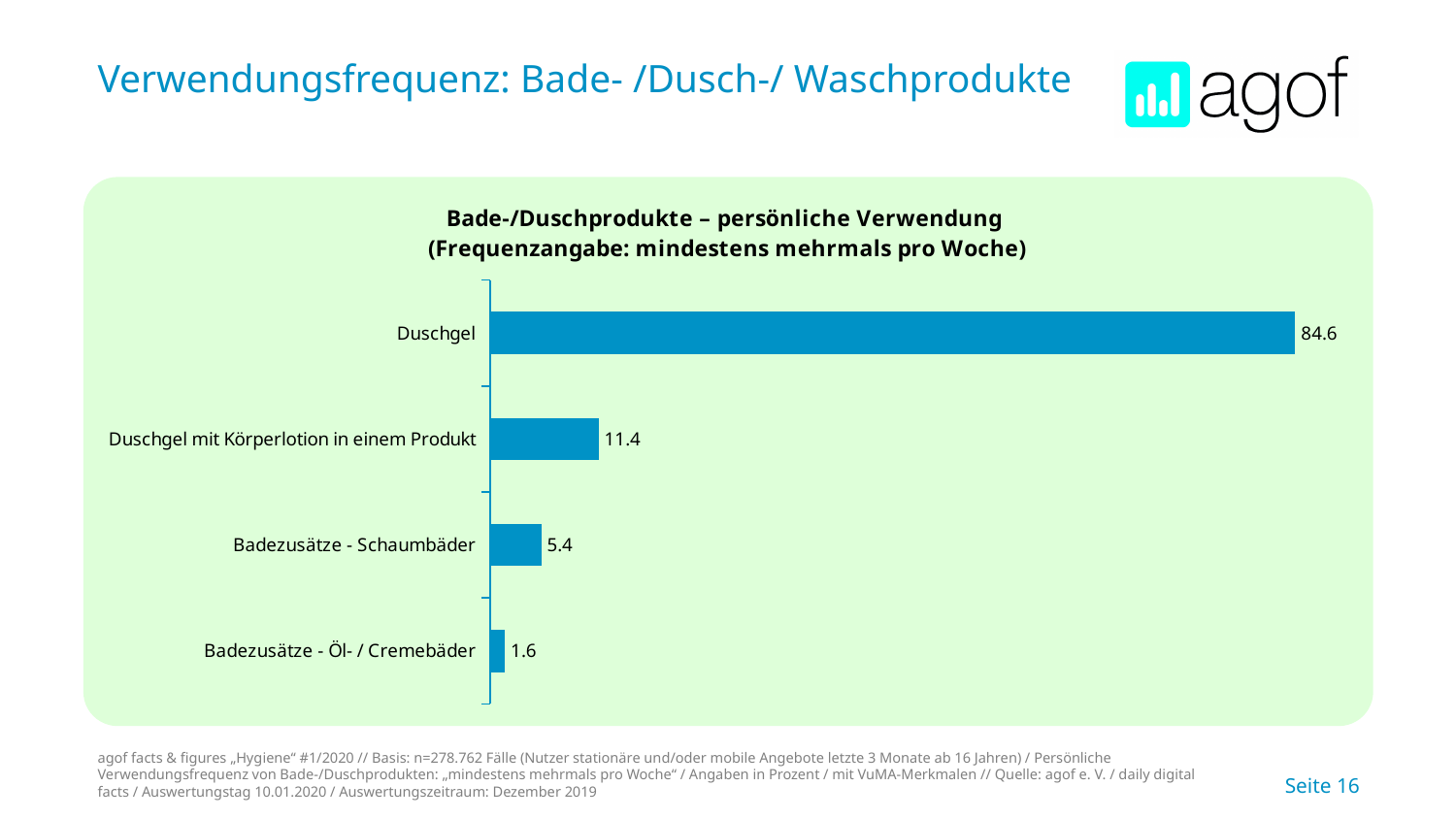
What kind of chart is shown on the slide? Bar chart What is the difference between the values for Duschgel and Duschgel mit Körperlotion in einem Produkt? 73.2 What is the value for Duschgel? 84.6 What is the value for Duschgel mit Körperlotion in einem Produkt? 11.4 How many categories are shown in the chart? 4 Which category has the highest value? Duschgel What is the value for Badezusätze - Schaumbäder? 5.4 What is the title of the chart? Bade-/Duschprodukte – persönliche Verwendung (Frequenzangabe: mindestens mehrmals pro Woche) Which is larger: the value for Duschgel mit Körperlotion in einem Produkt or for Badezusätze - Schaumbäder? Duschgel mit Körperlotion in einem Produkt Which category has the lowest value? Badezusätze - Öl- / Cremebäder What is the difference between the values for Badezusätze - Schaumbäder and Badezusätze - Öl- / Cremebäder? 3.8 What is the value for Badezusätze - Öl- / Cremebäder? 1.6